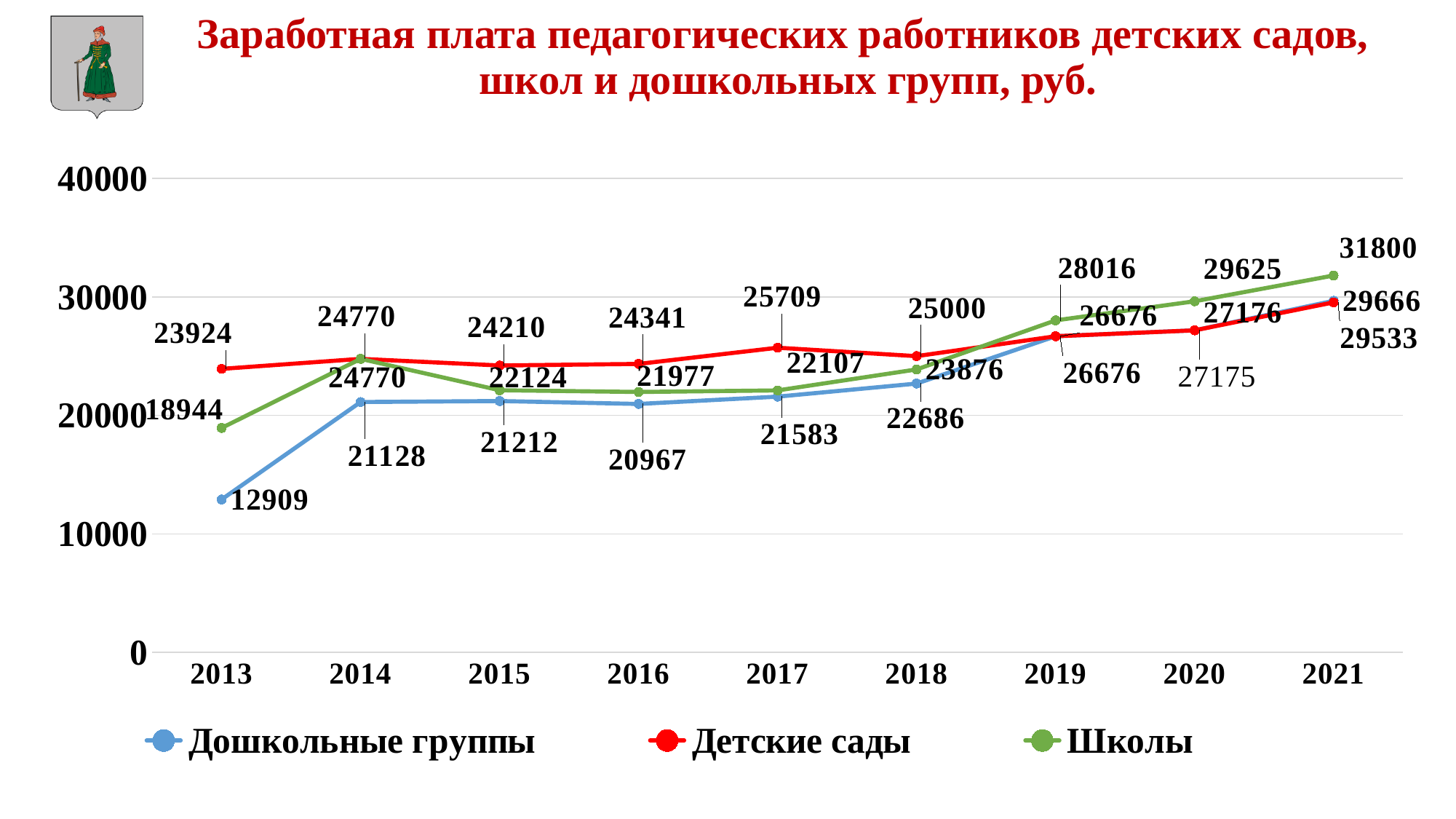
In 2013, which is larger: Детские сады or Дошкольные группы? Детские сады What is the value for Детские сады in 2013? 23924 What is the value for Школы in 2021? 31800 How many years are shown on the x axis? 9 What is the difference between the Школы values in 2021 and 2013? 12856 In which year is the value for Дошкольные группы lowest? 2013 What is the value for Школы in 2019? 28016 Is the value for Школы in 2021 greater or less than 30000? greater What is the value for Дошкольные группы in 2013? 12909 In which year is the value for Школы highest? 2021 How many series does the legend list? 3 What kind of chart is shown on the slide? line chart